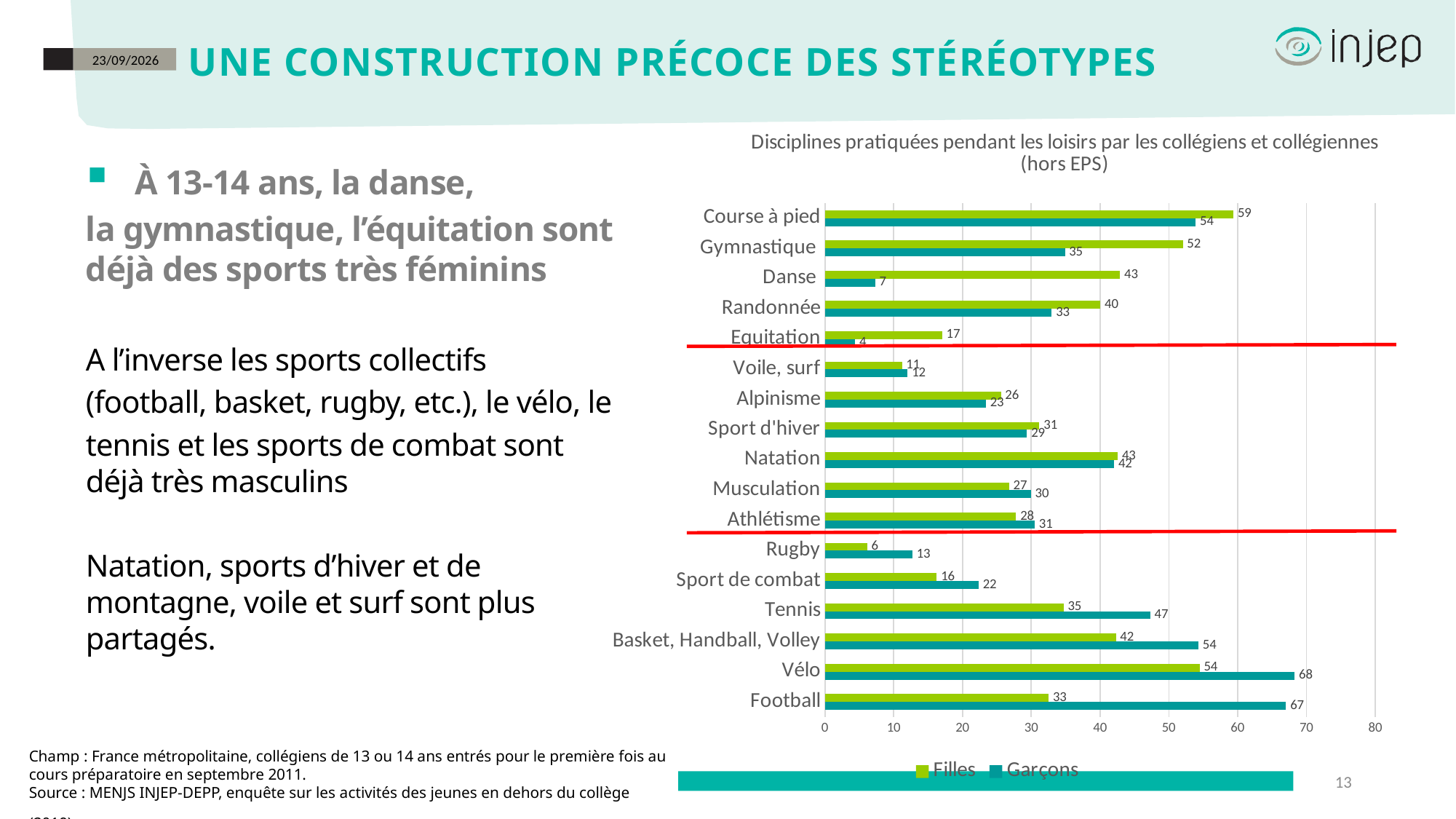
What is the difference between the Garçons and Filles values for Football? 34 What is the value for Garçons for Equitation? 4 What is the value for Garçons for Football? 67 What kind of chart is shown on the slide? Bar chart What is the value for Filles for Danse? 43 How many disciplines are shown on the chart? 17 For Tennis, which is larger: the value for Filles or for Garçons? Garçons How many series does the legend list? 2 Which discipline has the lowest value for Filles? Rugby Which discipline has the highest value for Filles? Course à pied What is the difference between the Filles and Garçons values for Gymnastique? 17 Which discipline has the highest value for Garçons? Vélo